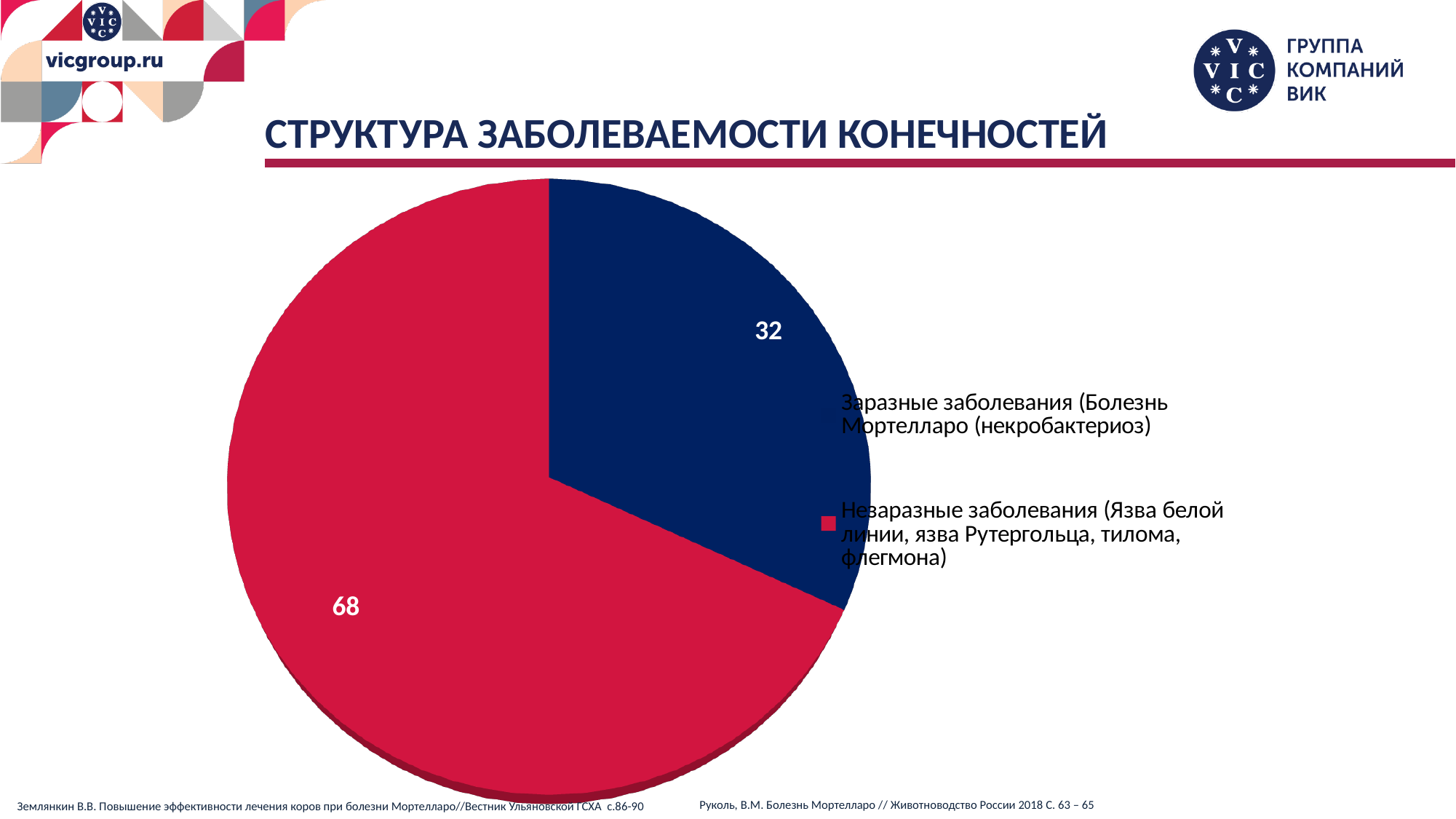
What is the value for Заразные заболевания (Болезнь Мортелларо (некробактериоз))? 32 How many slices does the pie chart have? 2 What is the total of the two values shown on the pie chart? 100 What kind of chart is shown on the slide? pie chart What colour is the slice for Заразные заболевания (Болезнь Мортелларо (некробактериоз))? dark blue What is the value for Незаразные заболевания (Язва белой линии, язва Рутергольца, тилома, флегмона)? 68 How many entries does the legend list? 2 Which category has the largest slice of the pie? Незаразные заболевания (Язва белой линии, язва Рутергольца, тилома, флегмона) What is the difference between the values for Незаразные заболевания and Заразные заболевания? 36 Which is larger: the value for Заразные заболевания or the value for Незаразные заболевания? Незаразные заболевания Which category has the smallest slice of the pie? Заразные заболевания (Болезнь Мортелларо (некробактериоз)) What is the title of the slide containing the chart? СТРУКТУРА ЗАБОЛЕВАЕМОСТИ КОНЕЧНОСТЕЙ